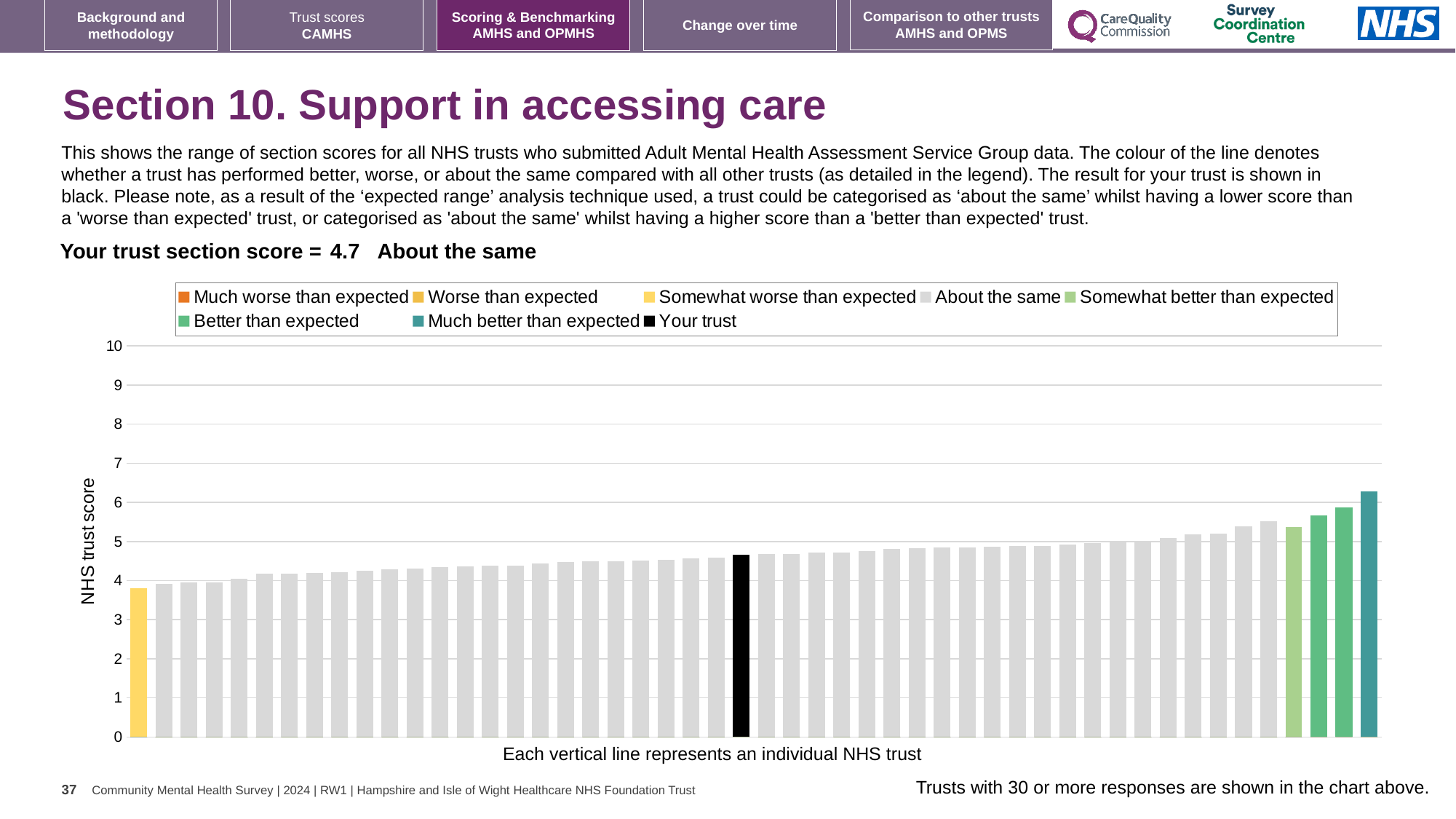
Which performance category is your trust placed in for this section? About the same What is the section score for your trust shown on the slide? 4.7 Which bar is the highest in the chart? the rightmost (teal) bar Do the bar values rise or fall from left to right along the x axis? rise Is the value for your trust (the black bar) greater or less than 5? less What kind of chart is shown on the slide? bar chart Is the value for the tallest bar (the rightmost, teal bar) greater or less than 6? greater What is the label on the y axis of the chart? NHS trust score Is the value for the leftmost (yellow) bar greater or less than 5? less What colour is the bar representing your trust? black How many entries does the chart legend list? 8 Which bar is the lowest in the chart? the leftmost (yellow) bar